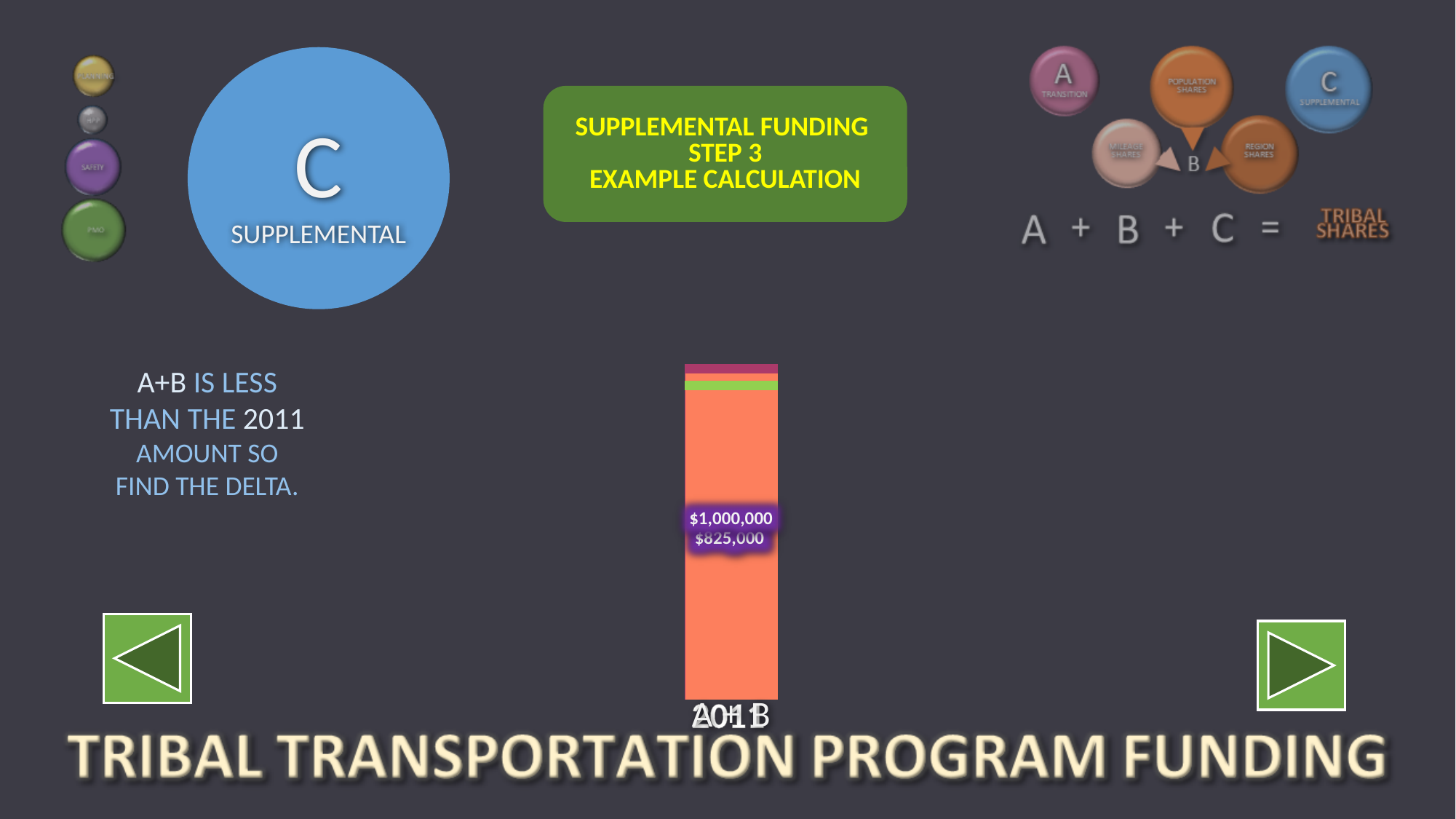
What colour is the largest segment of the bar in the chart? orange Is the value $825,000 printed on the chart greater or less than $1,000,000? less What is the smaller of the two dollar values printed on the bar in the chart? $825,000 What is the difference between the two dollar values printed on the bar, $1,000,000 and $825,000? $175,000 What kind of chart is shown in the centre of the slide? bar chart What is the larger of the two dollar values printed on the bar in the chart? $1,000,000 How many dollar values are printed as data labels on the chart? 2